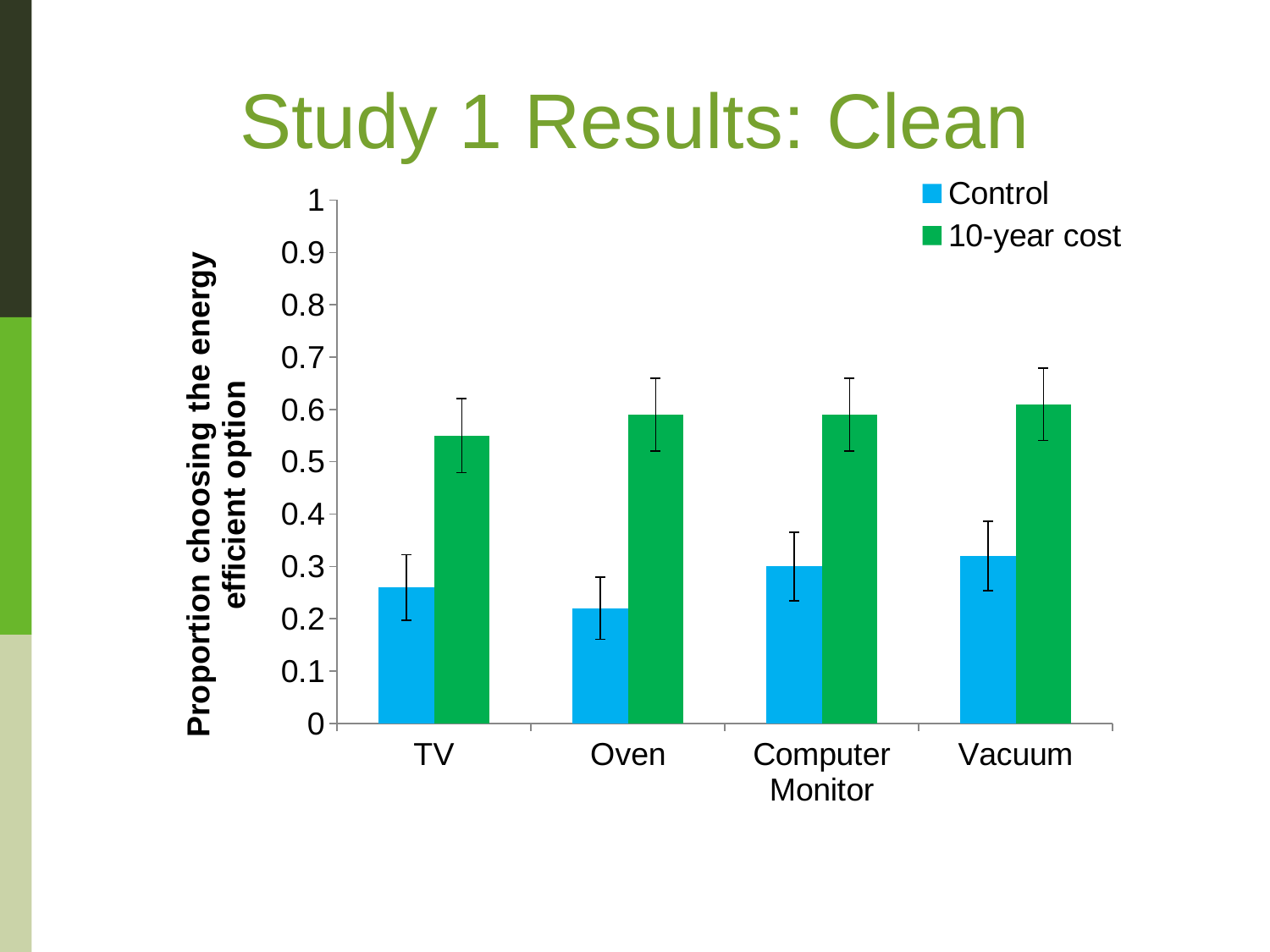
What is the title of the slide containing the chart? Study 1 Results: Clean Is the Control value for TV greater or less than 0.3? less For Computer Monitor, which is larger: the Control value or the 10-year cost value? 10-year cost Is the 10-year cost value for Oven greater or less than 0.5? greater Is the Control value for Oven greater or less than 0.3? less What kind of chart is shown on the slide? bar chart How many series does the legend list? 2 Which series does the blue bar represent? Control Which category has the lowest 10-year cost value? TV How many product categories are shown on the x axis? 4 Which category has the lowest Control value? Oven